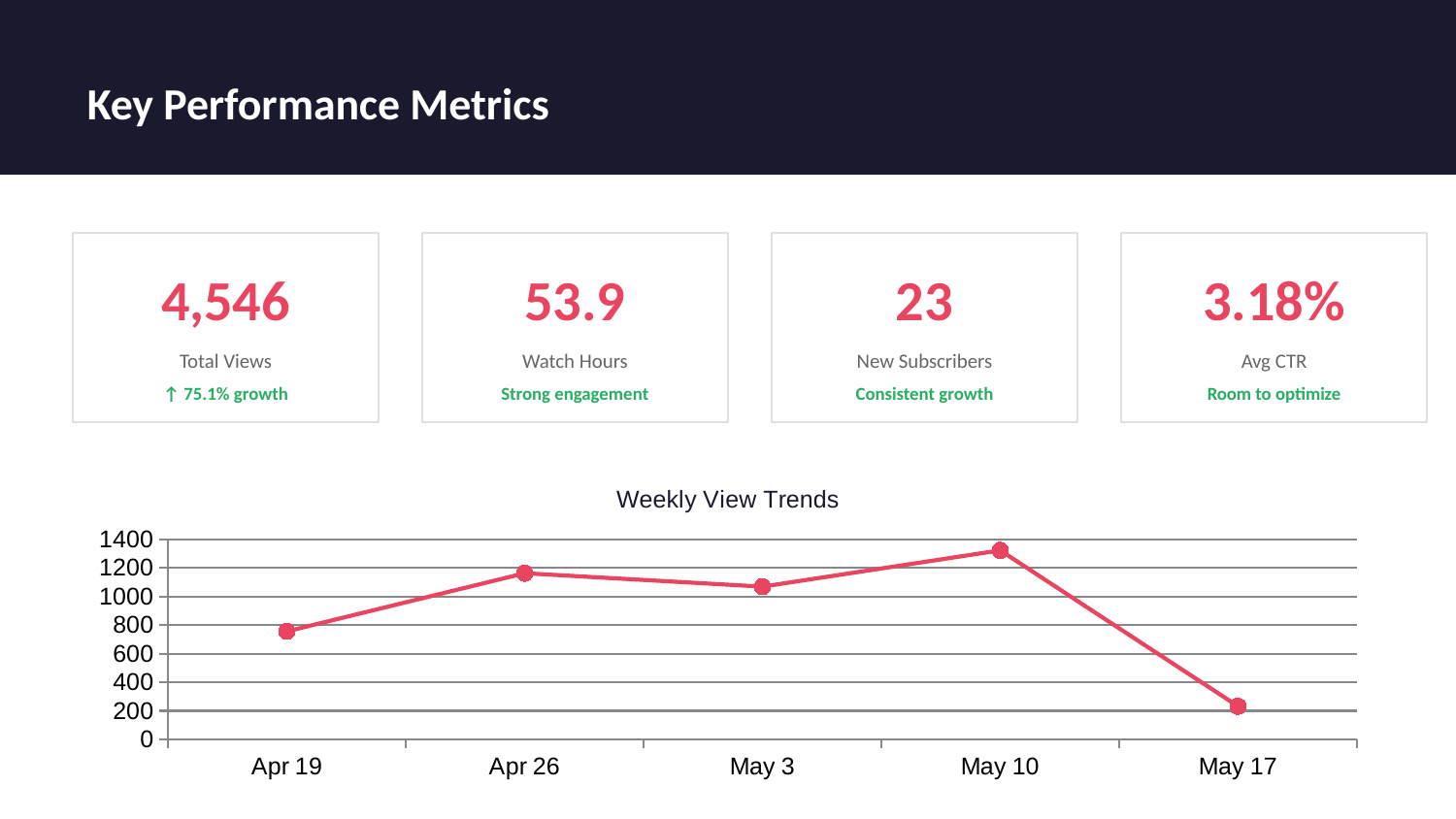
Is the value for Apr 26 greater or less than 1000? greater What is the title of the line chart on the slide? Weekly View Trends Between May 10 and May 17, do the values on the Weekly View Trends chart rise or fall? fall Which is larger on the Weekly View Trends chart, the value for May 3 or the value for May 10? May 10 Which week has the lowest value on the Weekly View Trends chart? May 17 Which week has the highest value on the Weekly View Trends chart? May 10 How many data points are plotted on the Weekly View Trends chart? 5 Is the value for May 10 greater or less than 1200? greater Is the value for May 17 greater or less than 400? less What kind of chart is the Weekly View Trends chart? line chart Which is larger on the Weekly View Trends chart, the value for Apr 19 or the value for Apr 26? Apr 26